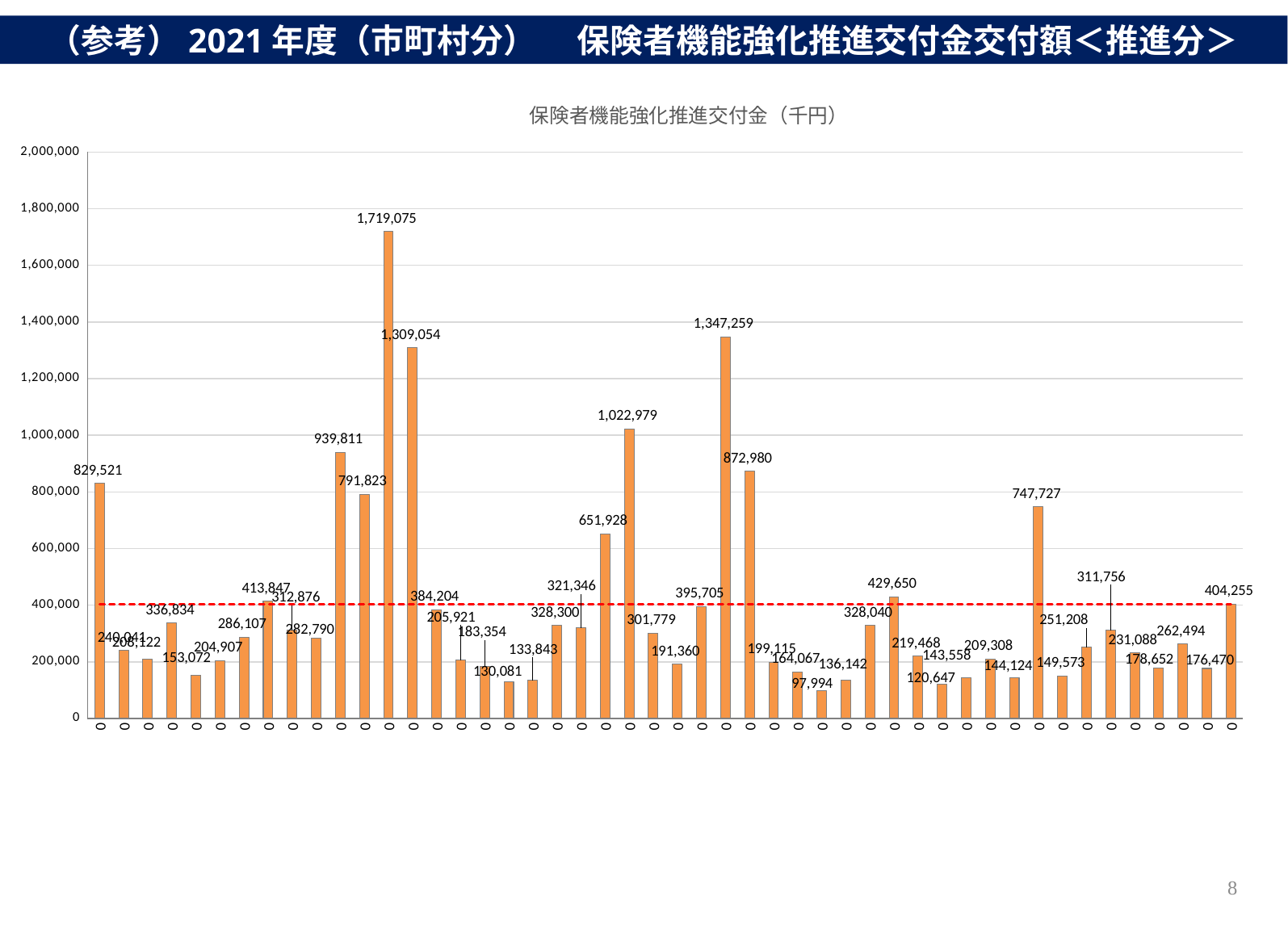
What is the value of the last (rightmost) bar in the chart? 404,255 What is the maximum value shown on the y axis? 2,000,000 What is the value of the first (leftmost) bar in the chart? 829,521 Which is larger, the leftmost bar or the rightmost bar? the leftmost bar (829,521) What is the title of the chart? 保険者機能強化推進交付金（千円） What is the lowest value shown in the chart? 97,994 What is the second highest value shown in the chart? 1,347,259 What kind of chart is shown on the slide? bar chart What is the difference between the highest and lowest values in the chart? 1,621,081 What is the highest value shown in the chart? 1,719,075 How many bars have values greater than 1,000,000? 4